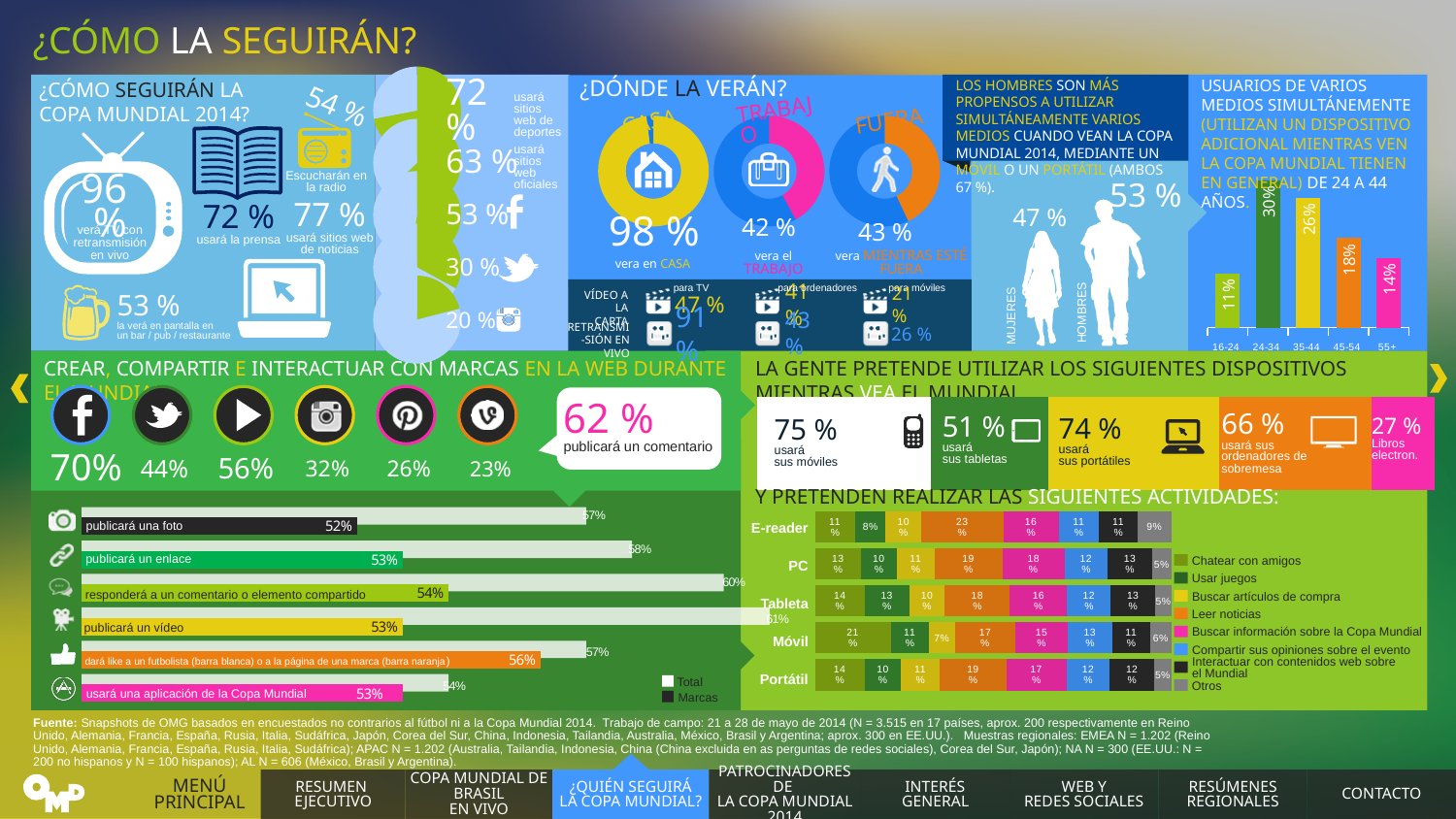
In the bottom-left horizontal bar chart, what is the Marcas value for 'publicará una foto'? 52% In the 'USUARIOS DE VARIOS MEDIOS SIMULTÁNEAMENTE' bar chart (top right), how many age groups are shown? 5 In the bottom-left horizontal bar chart, which is larger for 'responderá a un comentario o elemento compartido': Total or Marcas? Total In the 'USUARIOS DE VARIOS MEDIOS SIMULTÁNEAMENTE' bar chart (top right), which age group has the lowest value? 16-24 In the 'USUARIOS DE VARIOS MEDIOS SIMULTÁNEAMENTE' bar chart (top right), what is the difference between the 24-34 and 16-24 values? 19 percentage points In the bottom-left horizontal bar chart, what is the Total value for 'publicará un vídeo'? 61% In the 'USUARIOS DE VARIOS MEDIOS SIMULTÁNEAMENTE' bar chart (top right), what is the value for the 45-54 age group? 18% In the stacked bar chart under 'Y PRETENDEN REALIZAR LAS SIGUIENTES ACTIVIDADES', how many devices (categories) are shown? 5 In the stacked bar chart under 'Y PRETENDEN REALIZAR LAS SIGUIENTES ACTIVIDADES', how many activities does the legend list? 8 In the stacked bar chart under 'Y PRETENDEN REALIZAR LAS SIGUIENTES ACTIVIDADES', what is the 'Leer noticias' value for E-reader? 23% In the 'USUARIOS DE VARIOS MEDIOS SIMULTÁNEAMENTE' bar chart (top right), which age group has the highest value? 24-34 In the bottom-left horizontal bar chart, how many series does the legend list? 2